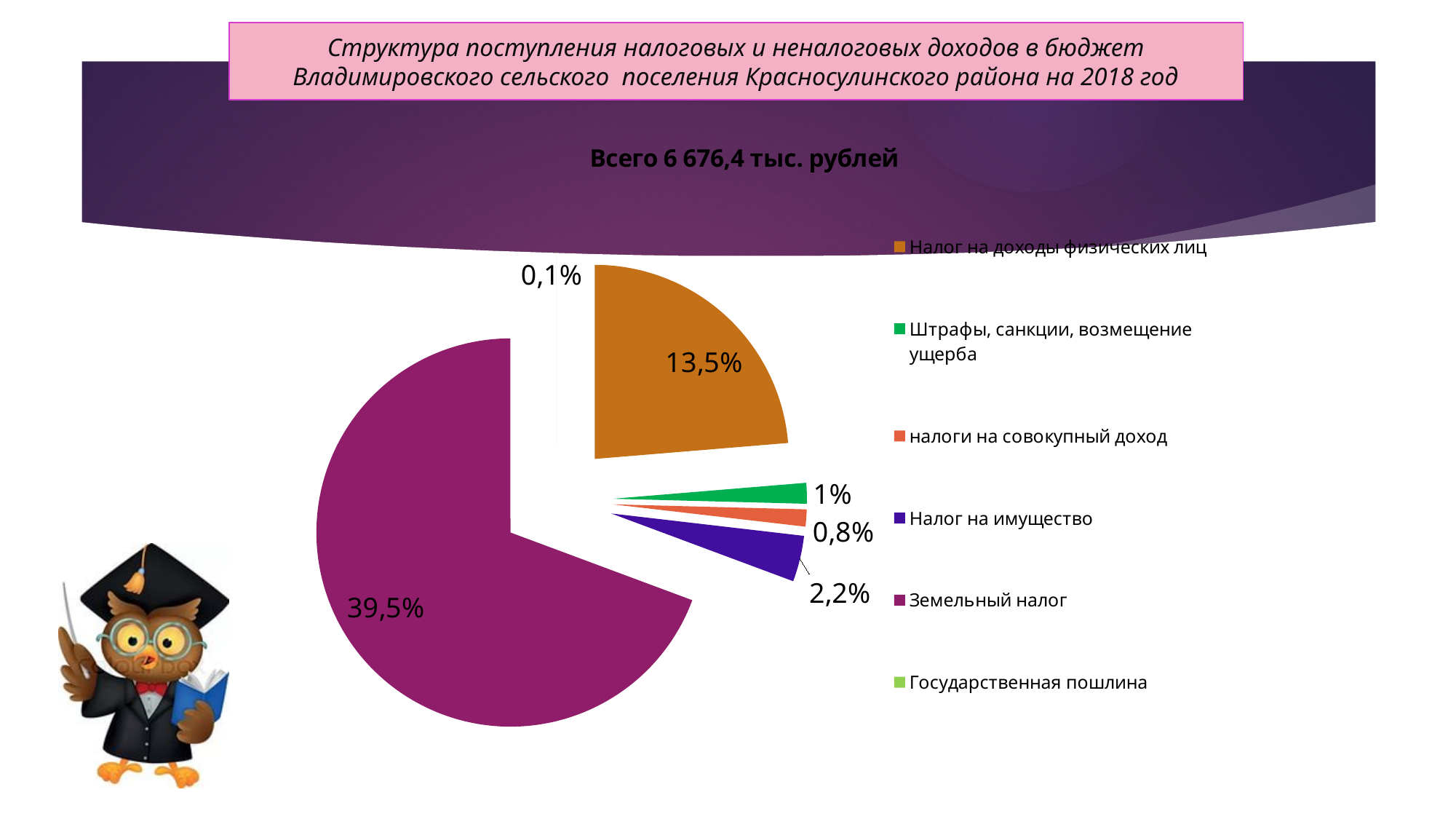
Which is larger: Штрафы, санкции, возмещение ущерба or налоги на совокупный доход? Штрафы, санкции, возмещение ущерба What is the difference between the values for Земельный налог and Налог на доходы физических лиц? 26% What total amount is stated above the chart? 6 676,4 тыс. рублей Which category has the smallest slice of the pie? Государственная пошлина How many categories does the legend list? 6 Which category has the largest slice of the pie? Земельный налог What is the value shown for Налог на имущество? 2,2% What is the value shown for Земельный налог? 39,5% What is the value shown for Налог на доходы физических лиц? 13,5% What is the value shown for налоги на совокупный доход? 0,8% What kind of chart is shown on the slide? pie chart What is the value shown for Государственная пошлина? 0,1%